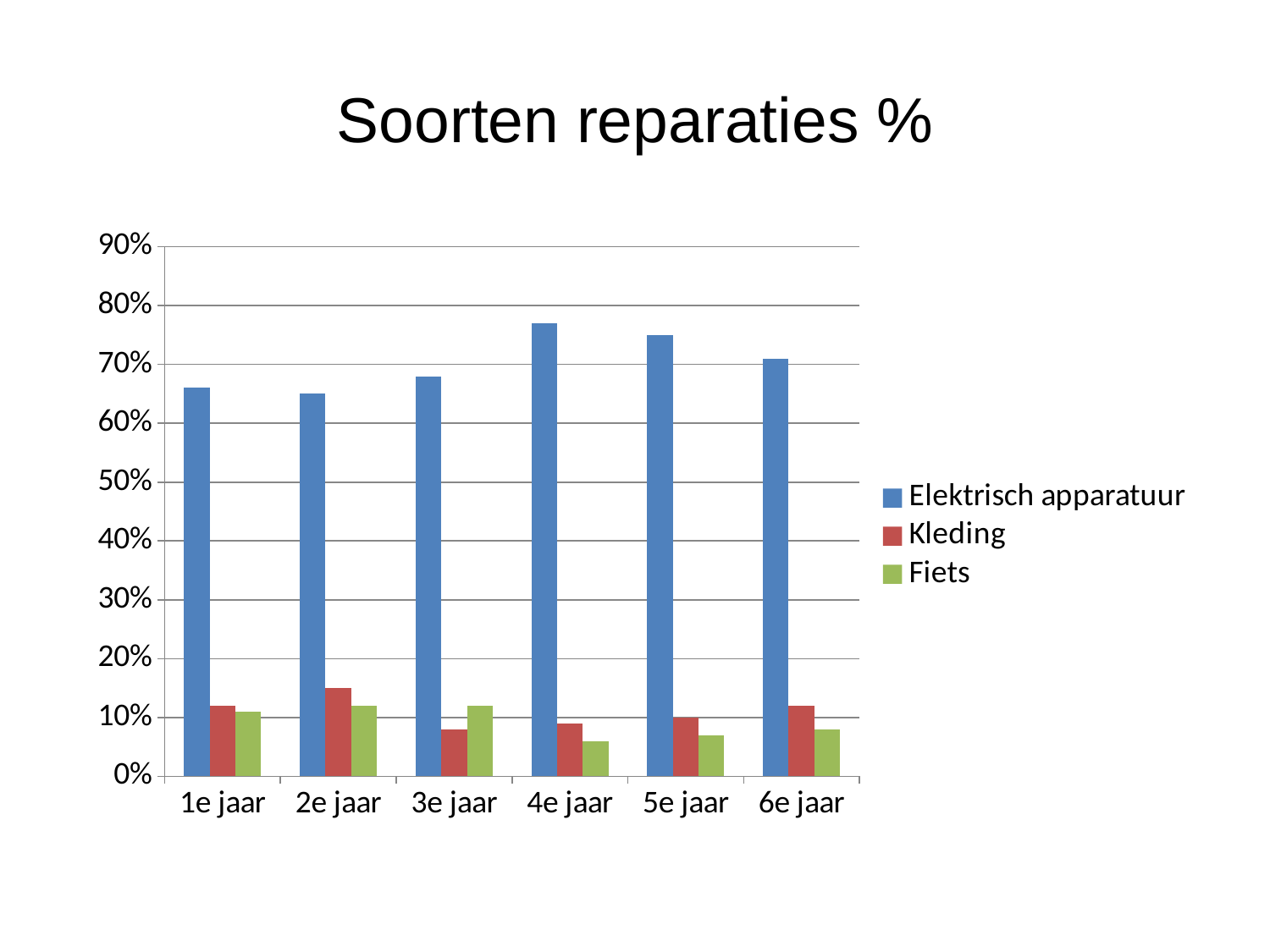
Is the value for Elektrisch apparatuur in 4e jaar greater or less than 70%? greater What kind of chart is shown on the slide? bar chart Is the value for Fiets in 4e jaar greater or less than 10%? less Is the value for Elektrisch apparatuur in 2e jaar greater or less than 70%? less Which is larger for Elektrisch apparatuur: 1e jaar or 4e jaar? 4e jaar How many series does the legend list? 3 What is the title of the chart? Soorten reparaties % How many categories are shown on the x axis? 6 In 2e jaar, which is larger: Kleding or Fiets? Kleding In which year is the value for Kleding highest? 2e jaar Which series is shown in blue? Elektrisch apparatuur